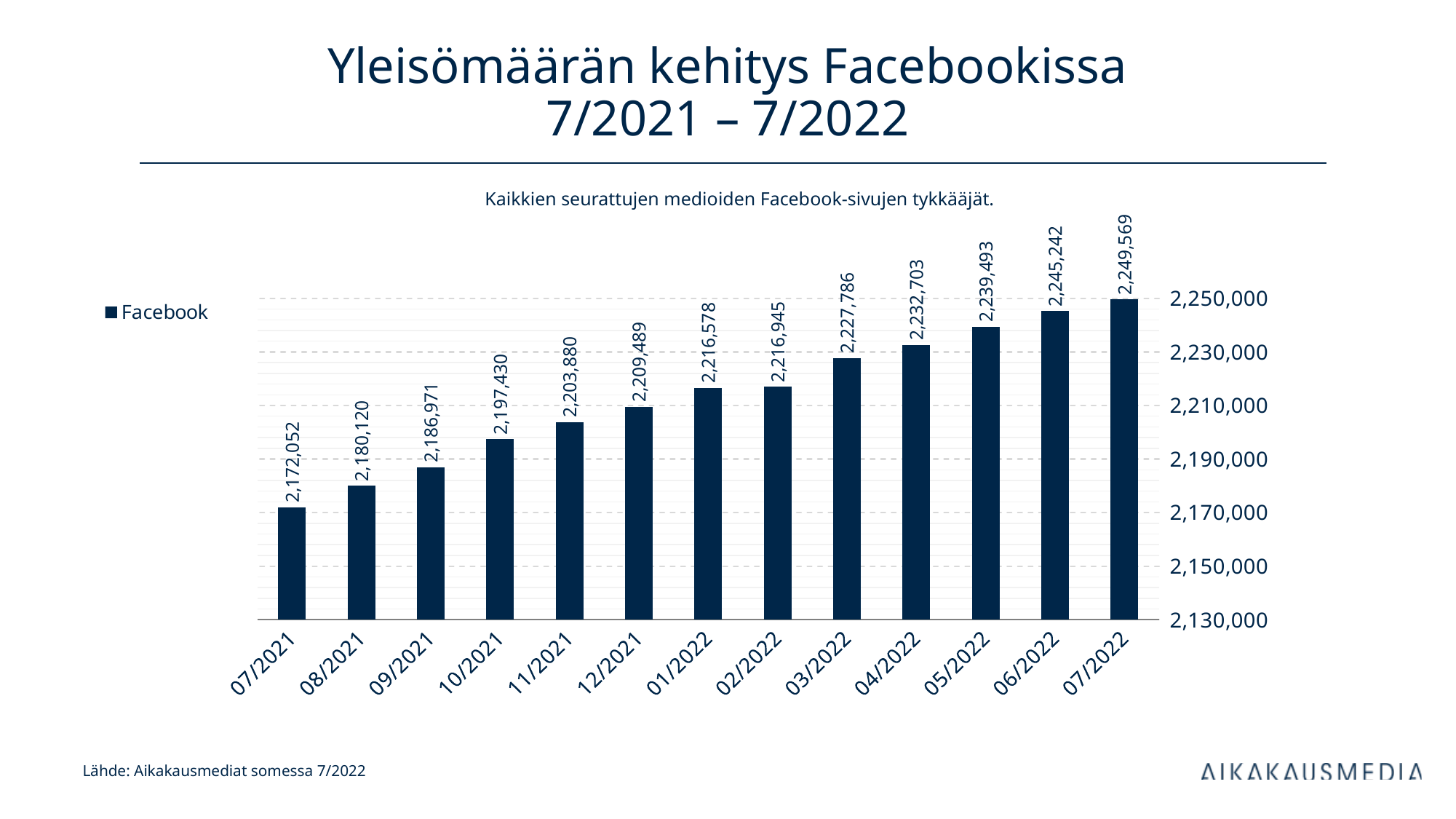
Which month has the lowest value? 07/2021 Which month has the highest value? 07/2022 Is the value for 10/2021 greater or less than 2,190,000? greater What is the difference between the values for 07/2022 and 07/2021? 77,517 What is the value for 01/2022? 2,216,578 How many months are shown on the x axis? 13 What is the value for 07/2021? 2,172,052 Which is larger, the value for 03/2022 or the value for 11/2021? 03/2022 What kind of chart is shown? bar chart Do the values rise or fall from 07/2021 to 07/2022? rise How many series does the legend list? 1 What is the value for 07/2022? 2,249,569